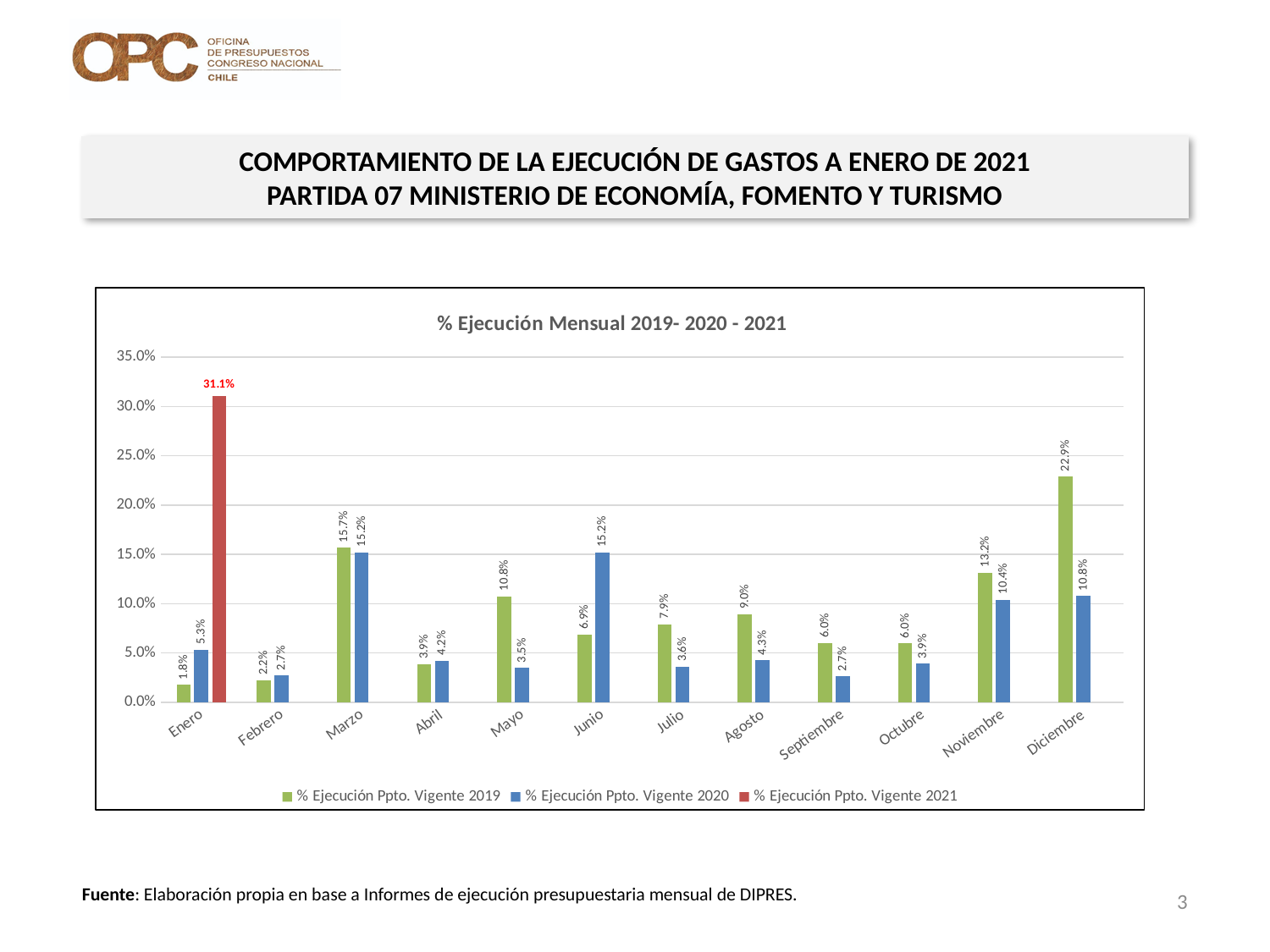
What type of chart is shown on the slide? bar chart What is the difference between the 2019 and 2020 values in Diciembre? 12.1% Which month has the highest value for % Ejecución Ppto. Vigente 2019? Diciembre How many series does the legend list? 3 How many months are shown on the x axis? 12 Is the value for % Ejecución Ppto. Vigente 2021 in Enero greater or less than 30.0%? greater What is the title of the chart? % Ejecución Mensual 2019- 2020 - 2021 Which month has the lowest value for % Ejecución Ppto. Vigente 2019? Enero In Mayo, which series has the larger value, 2019 or 2020? % Ejecución Ppto. Vigente 2019 What is the value for % Ejecución Ppto. Vigente 2019 in Diciembre? 22.9% What is the value for % Ejecución Ppto. Vigente 2020 in Junio? 15.2% What is the value for % Ejecución Ppto. Vigente 2021 in Enero? 31.1%